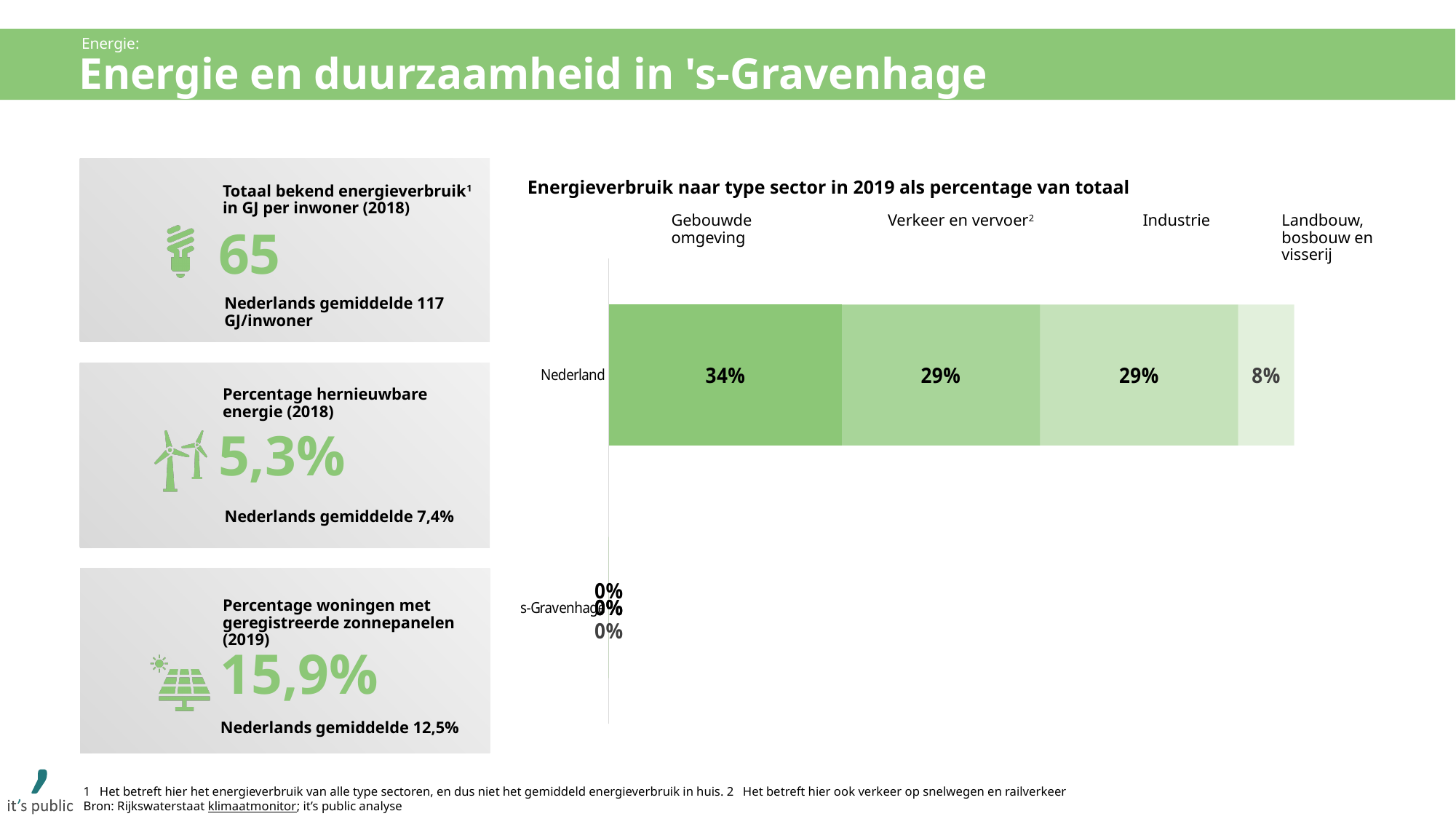
What is the difference between the Gebouwde omgeving and Industrie shares for Nederland? 5% What is the total of the Nederland stacked bar? 100% What type of chart is used to show energy consumption by sector? Stacked bar chart How many sectors (series) are shown in the chart? 4 Which sector has the largest share in the Nederland bar? Gebouwde omgeving What is the value for Landbouw, bosbouw en visserij in the Nederland bar? 8% For Nederland, which is larger: Gebouwde omgeving or Landbouw, bosbouw en visserij? Gebouwde omgeving What percentage of Nederland's energy consumption comes from Gebouwde omgeving? 34% What is the value for Industrie in the Nederland bar? 29% What is the value for Verkeer en vervoer in the Nederland bar? 29% What value is shown for 's-Gravenhage in the chart? 0% Which sector has the smallest share in the Nederland bar? Landbouw, bosbouw en visserij